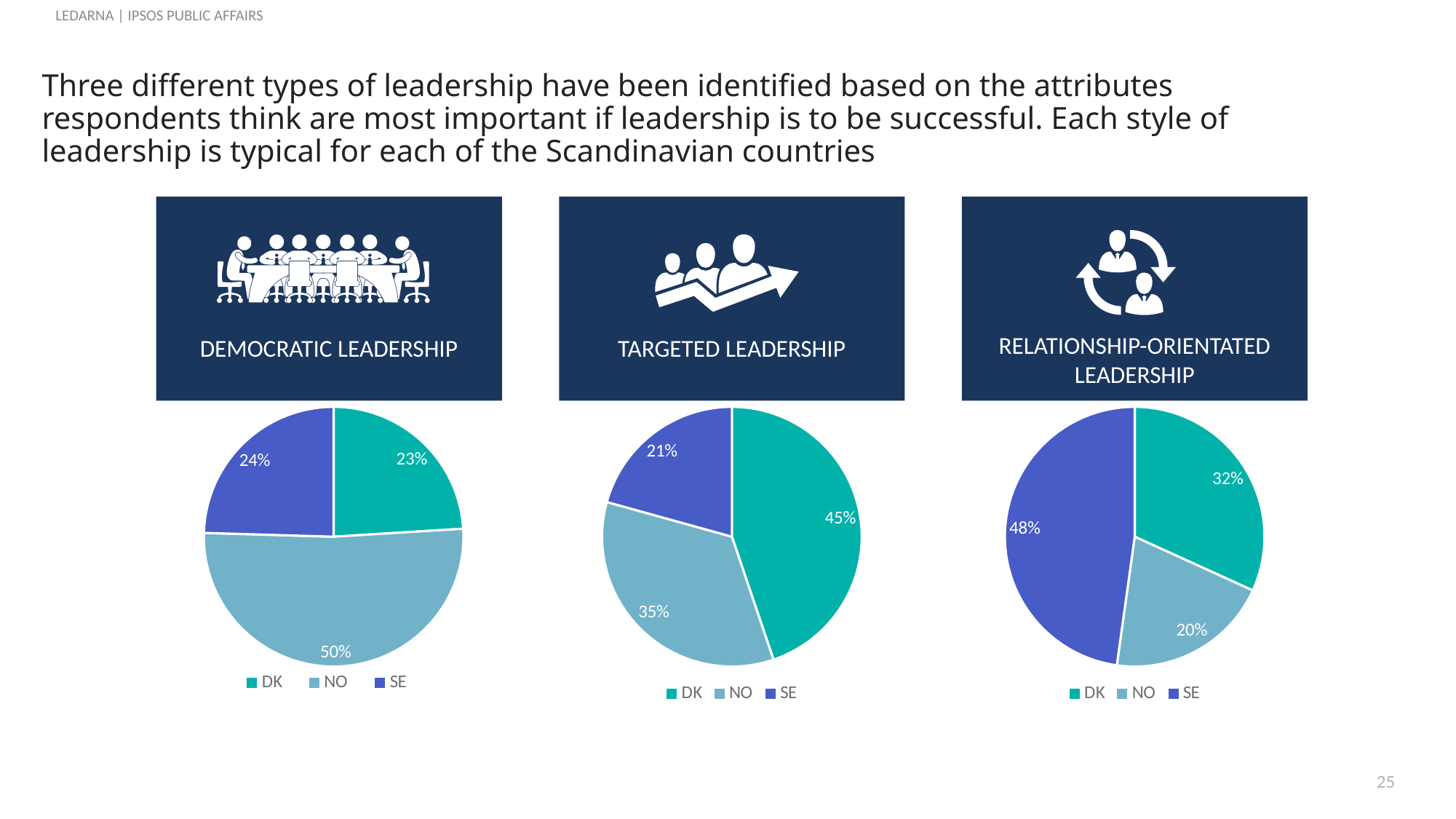
In the Targeted Leadership pie chart, what is the difference between the DK share and the NO share? 10% In the Relationship-Orientated Leadership pie chart, which country has the smallest share? NO How many slices does the Democratic Leadership pie chart have? 3 In the Democratic Leadership pie chart, what is the difference between the SE share and the DK share? 1% In the Democratic Leadership pie chart, what share does NO have? 50% In the Targeted Leadership pie chart, which country has the smallest share? SE In the Democratic Leadership pie chart, which country has the largest share? NO How many entries does the legend of the Targeted Leadership chart list? 3 What kind of chart is used under the Relationship-Orientated Leadership heading? Pie chart In the Relationship-Orientated Leadership pie chart, which is larger, the DK share or the NO share? DK In the Relationship-Orientated Leadership pie chart, what share does SE have? 48% In the Targeted Leadership pie chart, what share does DK have? 45%